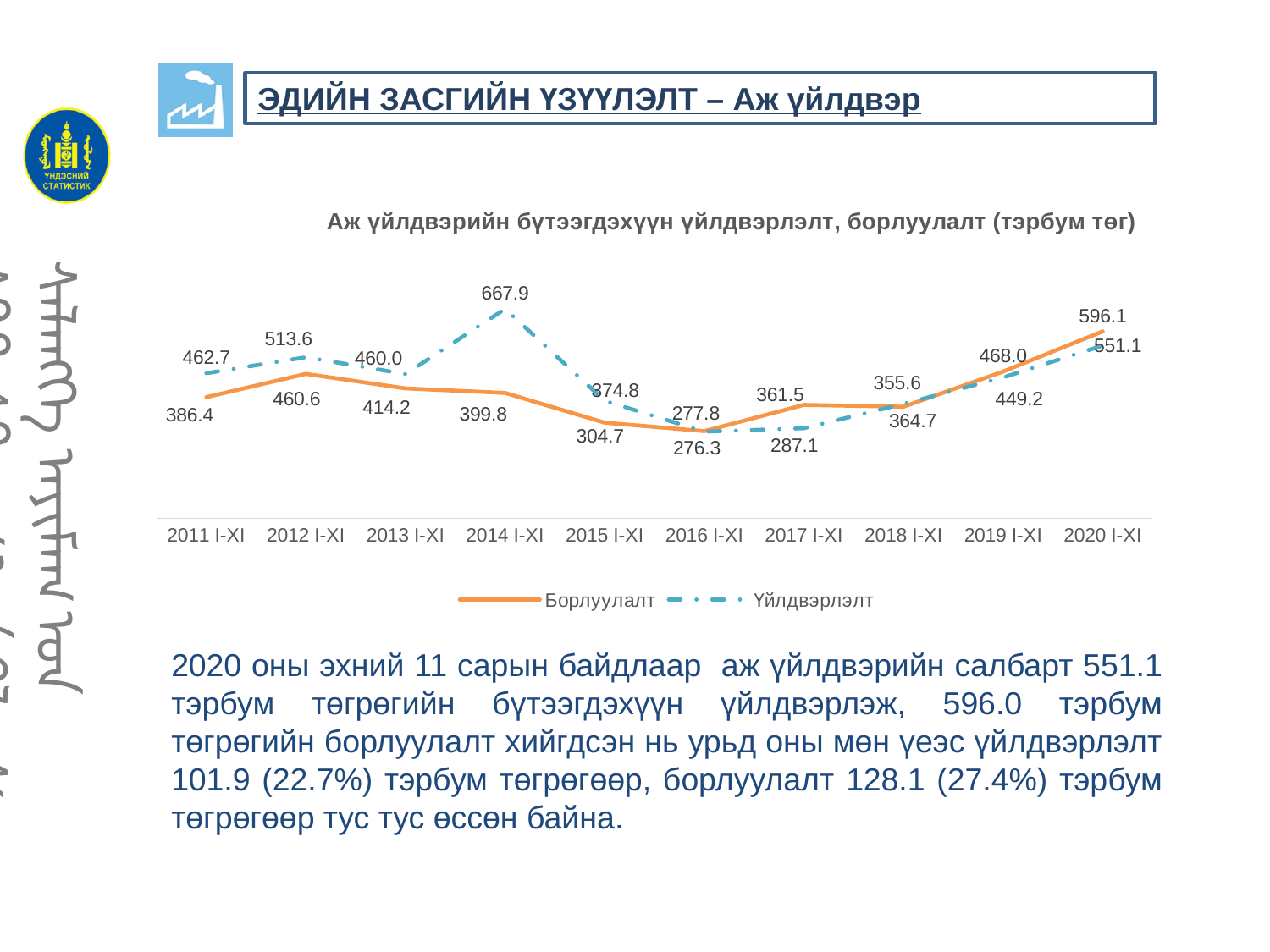
In which period is Борлуулалт lowest? 2016 I-XI In 2011 I-XI, which is larger: Борлуулалт or Үйлдвэрлэлт? Үйлдвэрлэлт How many periods are plotted along the x axis? 10 What is the value of Борлуулалт for 2015 I-XI? 304.7 What kind of chart is shown on the slide? line chart What is the value of Үйлдвэрлэлт for 2014 I-XI? 667.9 What is the value of Борлуулалт for 2020 I-XI? 596.1 In which period is Үйлдвэрлэлт highest? 2014 I-XI What is the difference between Борлуулалт and Үйлдвэрлэлт in 2020 I-XI? 45.0 Does Борлуулалт rise or fall from 2016 I-XI to 2020 I-XI? rise How many series does the legend list? 2 What is the title of the chart? Аж үйлдвэрийн бүтээгдэхүүн үйлдвэрлэлт, борлуулалт (тэрбум төг)